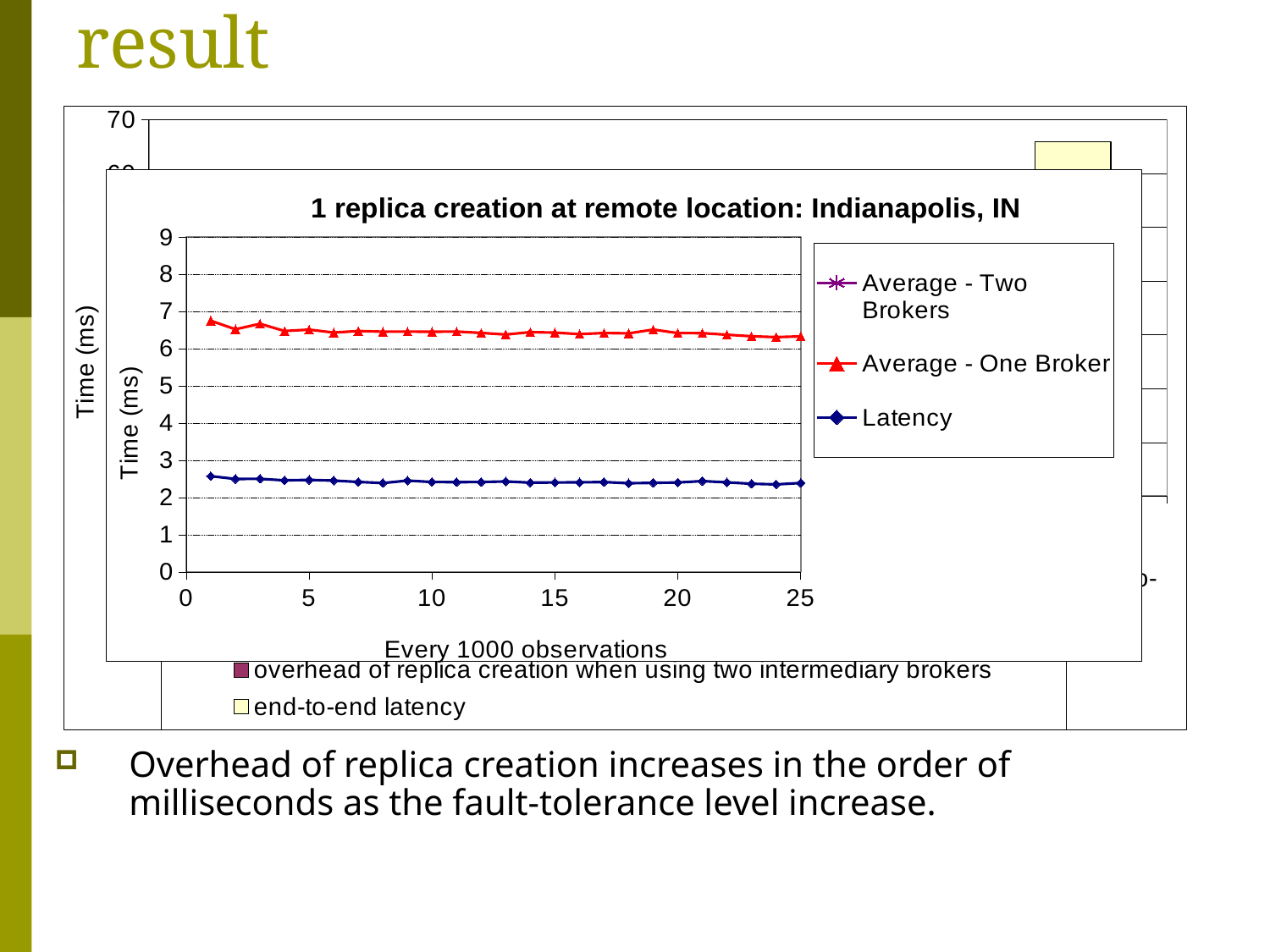
In the chart '1 replica creation at remote location: Indianapolis, IN', does the Average - One Broker series rise sharply, fall sharply, or stay roughly flat along the x axis? roughly flat In the chart '1 replica creation at remote location: Indianapolis, IN', is the value for Latency at x = 5 greater or less than 3? less In the chart '1 replica creation at remote location: Indianapolis, IN', how many series does the legend list? 3 In the chart '1 replica creation at remote location: Indianapolis, IN', is the value for Latency at x = 15 greater or less than 2? greater In the chart '1 replica creation at remote location: Indianapolis, IN', is the value for Average - One Broker at x = 10 greater or less than 5? greater In the chart '1 replica creation at remote location: Indianapolis, IN', does the Latency series rise sharply, fall sharply, or stay roughly flat along the x axis? roughly flat In the chart '1 replica creation at remote location: Indianapolis, IN', which series has higher values, Average - One Broker or Latency? Average - One Broker What kind of chart is the front chart titled '1 replica creation at remote location: Indianapolis, IN'? line chart What is the x-axis label of the chart '1 replica creation at remote location: Indianapolis, IN'? Every 1000 observations What is the y-axis label of the chart '1 replica creation at remote location: Indianapolis, IN'? Time (ms)